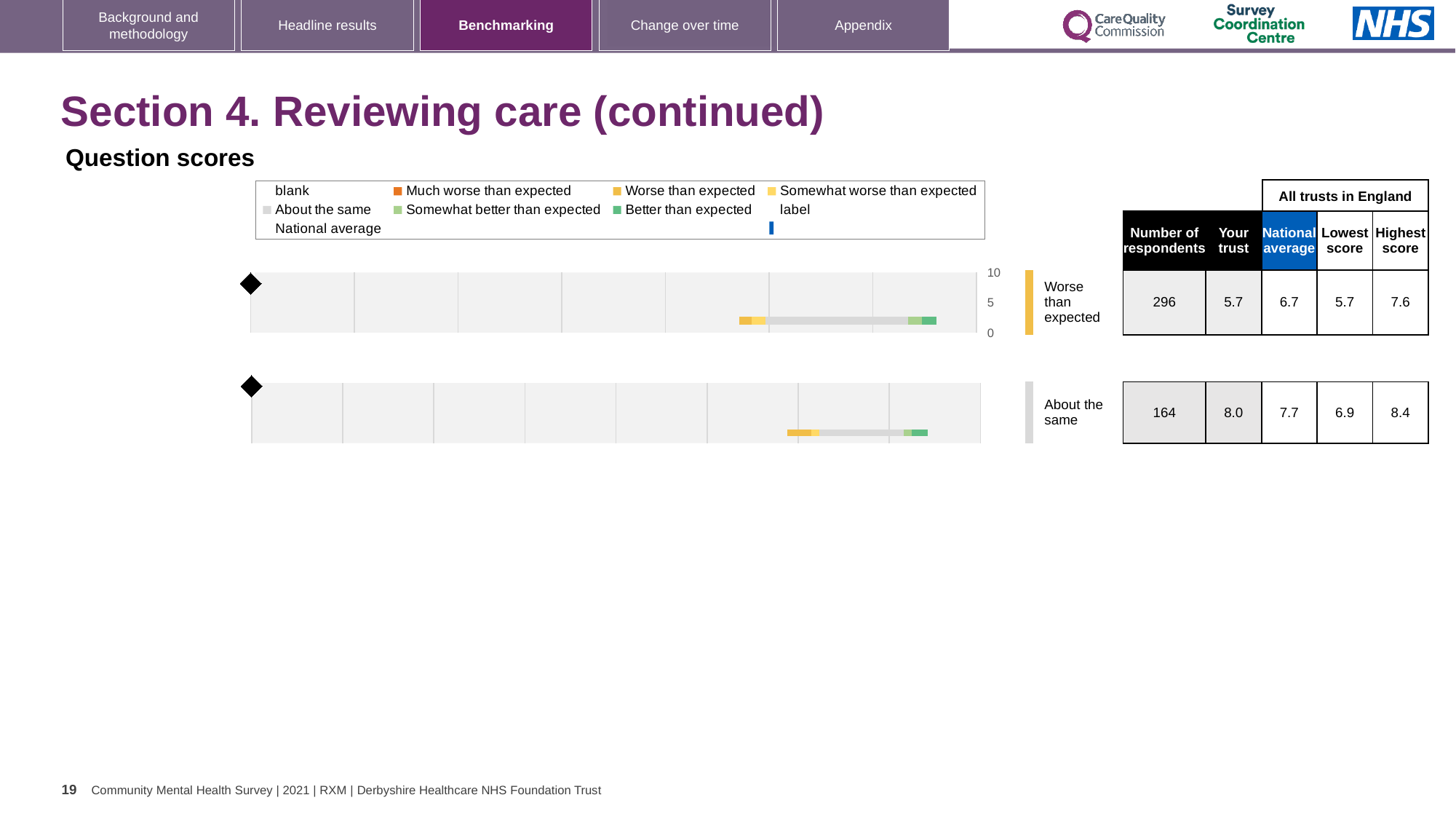
Which question has the higher 'Your trust' score: the one rated 'Worse than expected' or the one rated 'About the same'? About the same What is the 'Your trust' score for the question rated 'Worse than expected'? 5.7 What kind of chart is used to show the question scores on this slide? bar chart What is the difference between the highest score and the lowest score for the question rated 'Worse than expected'? 1.9 What is the lowest score among all trusts in England for the question rated 'About the same'? 6.9 What is the maximum value shown on the score axis of the charts? 10 How many question score bars are plotted on the slide? 2 What is the national average for the question rated 'About the same'? 7.7 What heading appears above the 'Lowest score' and 'Highest score' columns? All trusts in England By how much does the 'Your trust' score exceed the national average for the question rated 'About the same'? 0.3 How many respondents answered the question rated 'Worse than expected'? 296